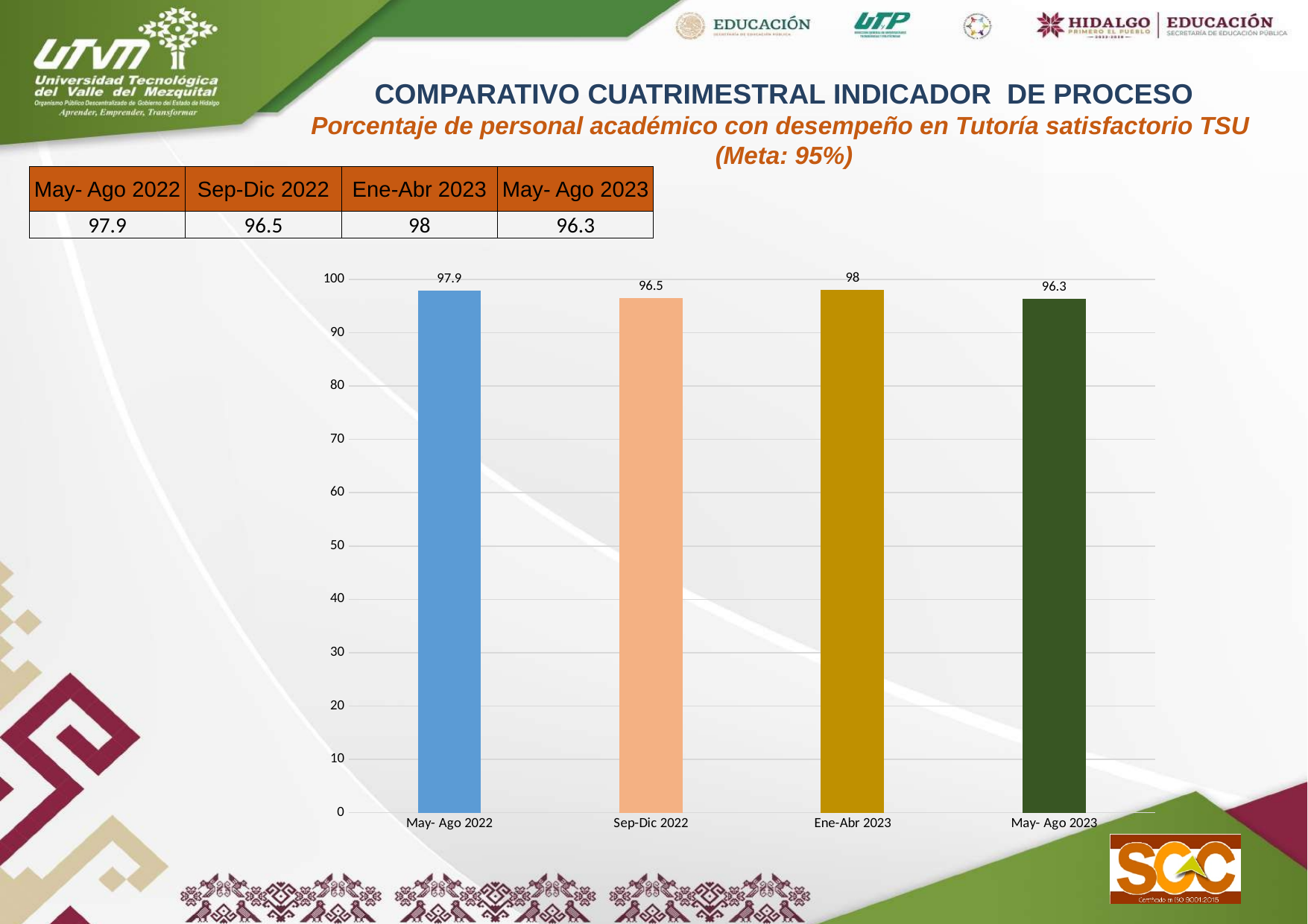
Which period has the lowest value? May- Ago 2023 What is the value for Ene-Abr 2023? 98 What is the value for May- Ago 2023? 96.3 What is the difference between the values for Ene-Abr 2023 and May- Ago 2023? 1.7 What kind of chart is shown on the slide? bar chart Is the value for Sep-Dic 2022 greater or less than 90? greater Which period has the highest value? Ene-Abr 2023 What is the value for Sep-Dic 2022? 96.5 What is the target (Meta) stated in the chart subtitle? 95% What is the value for May- Ago 2022? 97.9 How many periods are shown on the chart? 4 Which is larger, the value for May- Ago 2022 or the value for Sep-Dic 2022? May- Ago 2022